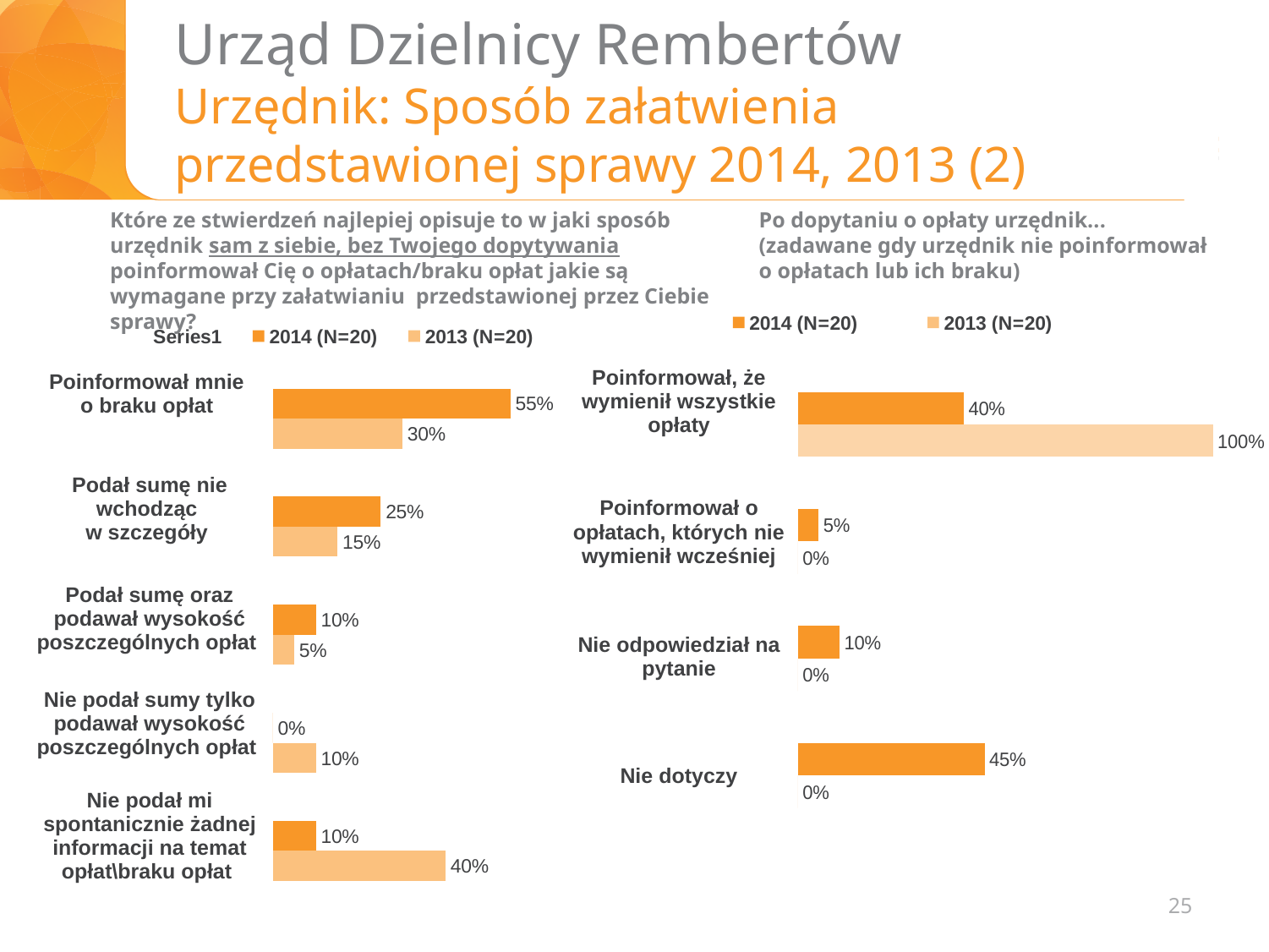
In the right chart, what is the 2013 (N=20) value for "Poinformował, że wymienił wszystkie opłaty"? 100% In the right chart, what is the difference between the 2013 and 2014 values for "Poinformował, że wymienił wszystkie opłaty"? 60% In the left chart, what is the 2014 (N=20) value for "Poinformował mnie o braku opłat"? 55% How many categories does the right chart show? 4 In the left chart, what is the 2013 (N=20) value for "Nie podał mi spontanicznie żadnej informacji na temat opłat\braku opłat"? 40% In the left chart, what is the difference between the 2014 and 2013 values for "Poinformował mnie o braku opłat"? 25% In the right chart, what is the 2014 (N=20) value for "Nie dotyczy"? 45% In the left chart, which is larger for "Podał sumę nie wchodząc w szczegóły": the 2014 value or the 2013 value? 2014 In the right chart, which category has the highest 2014 (N=20) value? Nie dotyczy What type of chart is the right chart? Bar chart In the left chart, which category has the highest 2014 (N=20) value? Poinformował mnie o braku opłat How many categories does the left chart show? 5